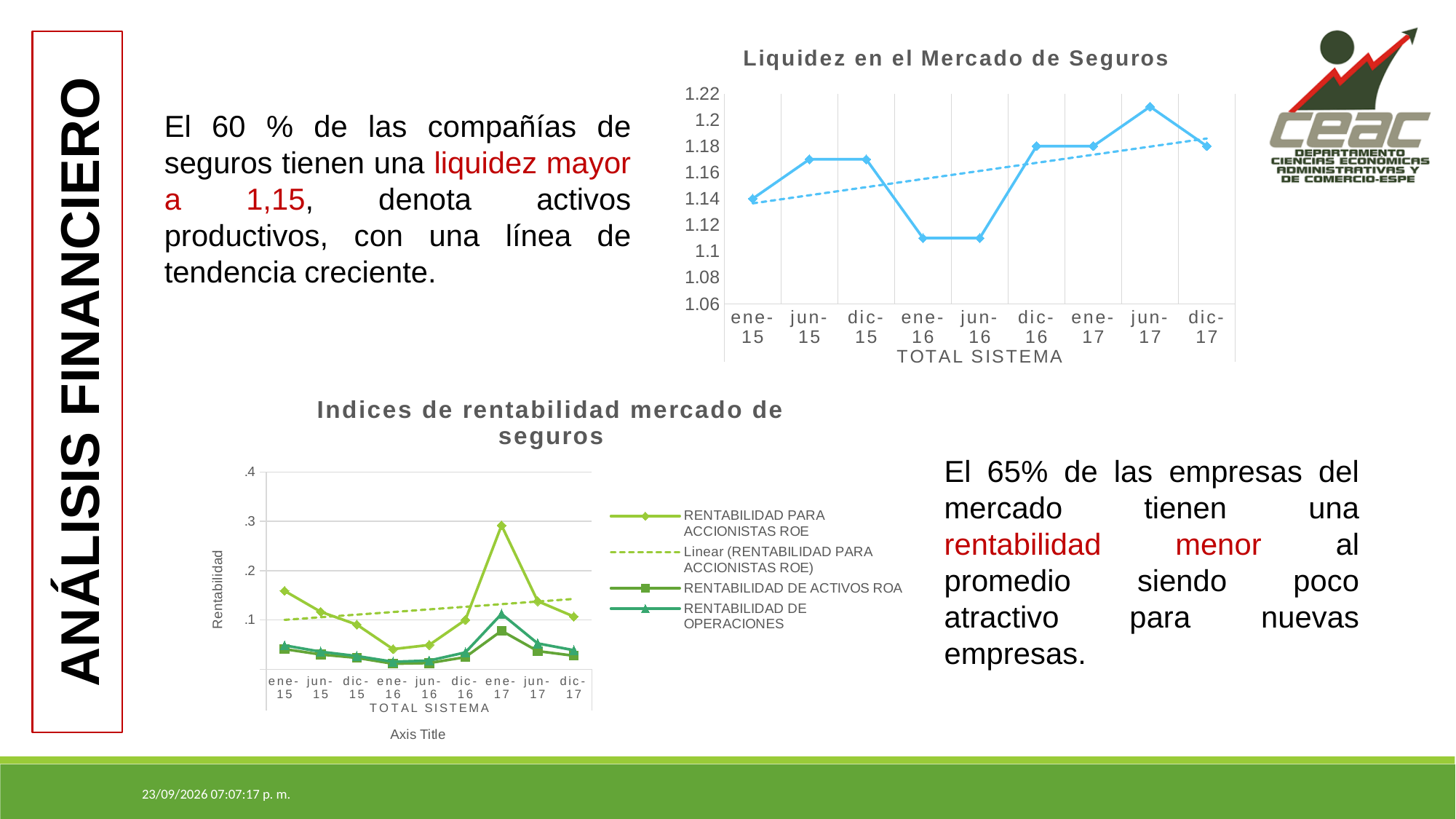
In the 'Liquidez en el Mercado de Seguros' chart, how many time points are plotted along the x axis? 9 In the 'Indices de rentabilidad mercado de seguros' chart, in which period does RENTABILIDAD PARA ACCIONISTAS ROE reach its highest value? ene-17 In the 'Liquidez en el Mercado de Seguros' chart, does the dashed trend line rise or fall from ene-15 to dic-17? rise How many entries does the legend of the 'Indices de rentabilidad mercado de seguros' chart list? 4 In the 'Liquidez en el Mercado de Seguros' chart, is the value for ene-16 greater or less than 1.12? less In the 'Liquidez en el Mercado de Seguros' chart, which is larger, the value for jun-17 or the value for ene-15? jun-17 In the 'Liquidez en el Mercado de Seguros' chart, which period has the highest liquidity value? jun-17 What is the vertical axis title of the 'Indices de rentabilidad mercado de seguros' chart? Rentabilidad In the 'Indices de rentabilidad mercado de seguros' chart, how many periods are plotted along the x axis? 9 What kind of chart is the 'Liquidez en el Mercado de Seguros' chart? line chart In the 'Indices de rentabilidad mercado de seguros' chart, is the RENTABILIDAD PARA ACCIONISTAS ROE value for ene-17 greater or less than .2? greater In the 'Liquidez en el Mercado de Seguros' chart, is the value for jun-17 greater or less than 1.2? greater